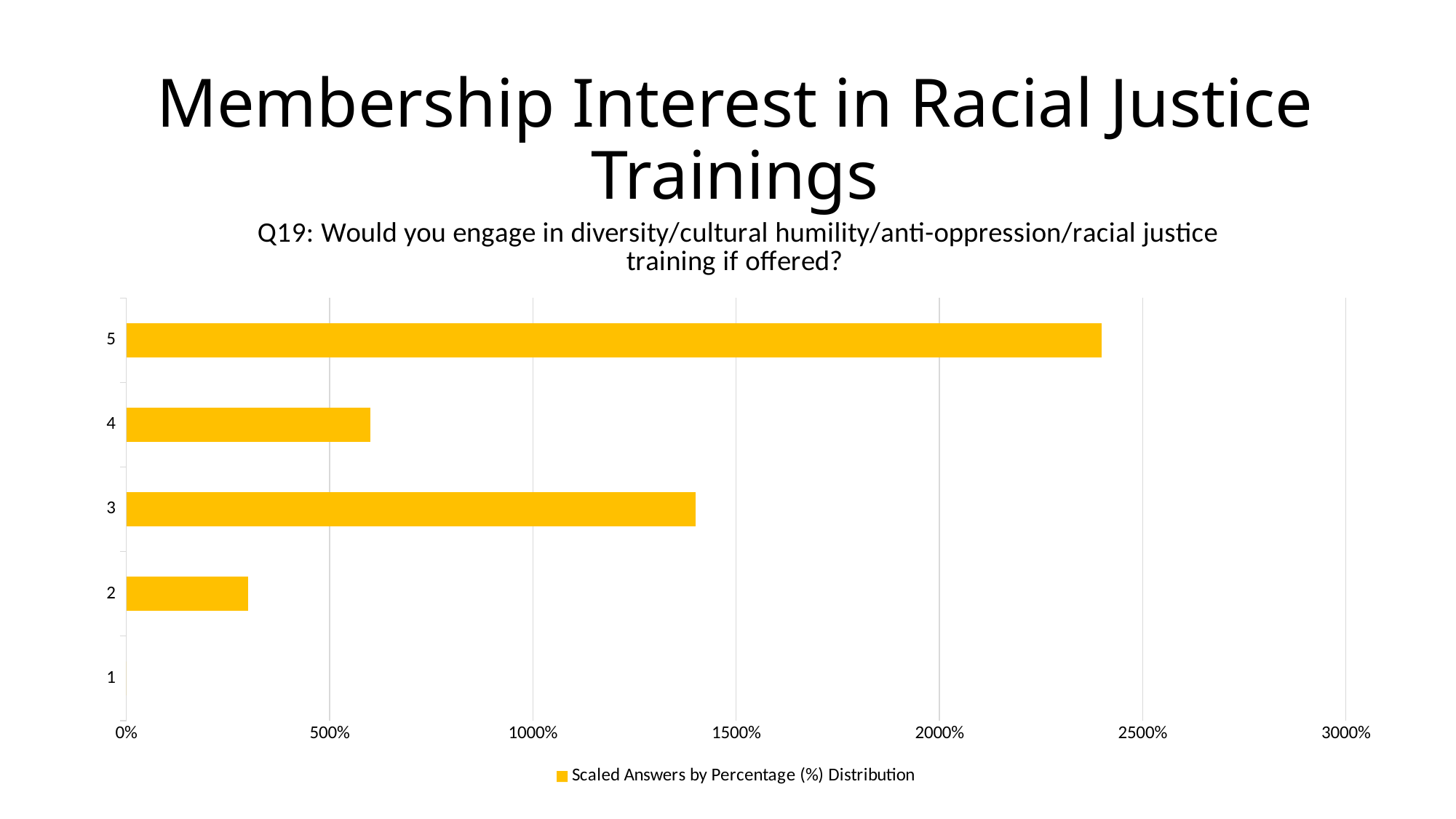
Is the value for category 2 greater or less than 500%? less How many categories are shown on the vertical axis of the chart? 5 Which category has the smallest value? 1 How many series does the chart legend list? 1 What kind of chart is shown on the slide? bar chart What is the highest value labelled on the horizontal axis? 3000% Is the value for category 5 greater or less than 2000%? greater Is the value for category 4 greater or less than 1000%? less What is the name of the series shown in the chart legend? Scaled Answers by Percentage (%) Distribution Which category has the longest bar? 5 Which has the larger value, category 3 or category 4? 3